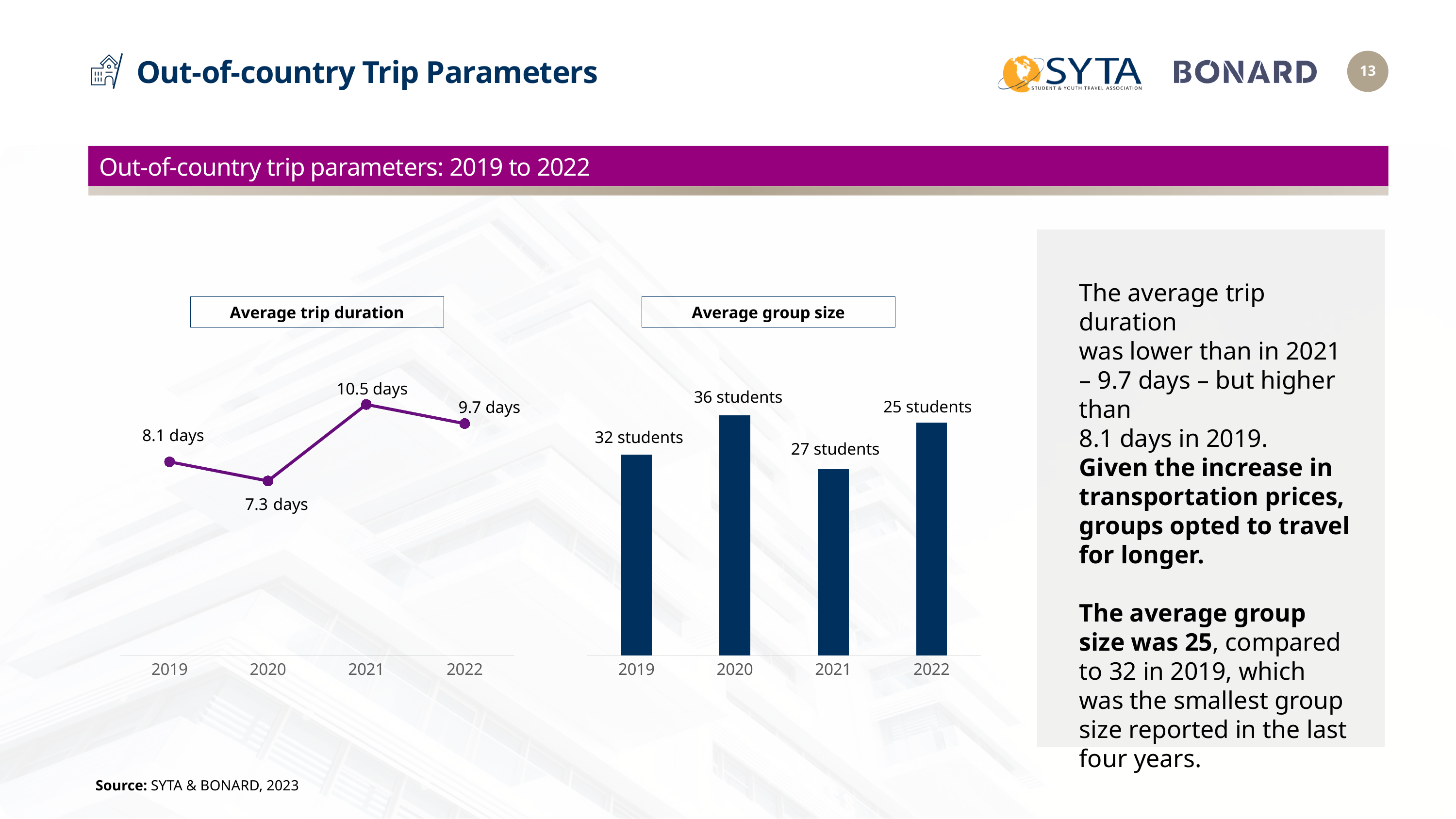
In the 'Average group size' chart, what is the difference between the 2019 and 2022 values? 7 students In the 'Average group size' chart, what was the average group size in 2022? 25 students What kind of chart is the 'Average trip duration' chart? Line chart In the 'Average trip duration' chart, which year had the lowest average trip duration? 2020 In the 'Average group size' chart, which year had the smallest average group size? 2022 In the 'Average trip duration' chart, which year had the highest average trip duration? 2021 In the 'Average group size' chart, what was the average group size in 2020? 36 students In the 'Average trip duration' chart, what was the average trip duration in 2020? 7.3 days In the 'Average group size' chart, which year had the largest average group size? 2020 In the 'Average trip duration' chart, what was the average trip duration in 2021? 10.5 days In the 'Average trip duration' chart, what is the difference between the 2021 and 2019 values? 2.4 days What kind of chart is the 'Average group size' chart? Bar chart